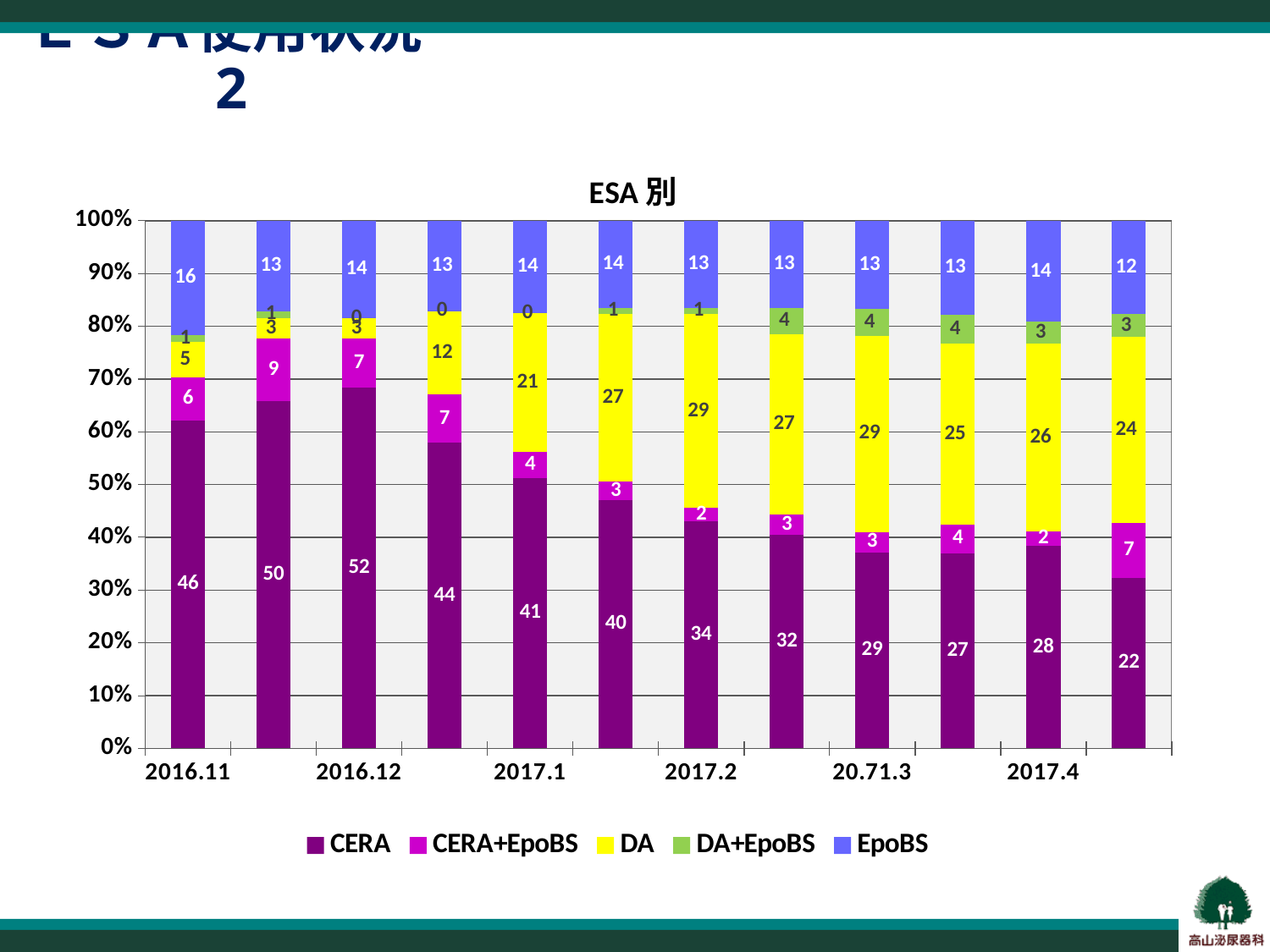
What kind of chart is shown on the slide? Stacked bar chart How many series does the legend list? 5 What is the CERA value for 2016.11? 46 What is the difference between the CERA value for 2016.11 and the CERA value for 2017.4? 18 What is the DA value for 2017.2? 29 What is the CERA value for 2017.4? 28 What is the title of the chart? ESA 別 What is the EpoBS value for 2016.11? 16 Among the labeled x-axis categories, which has the highest CERA value? 2016.12 Which is larger: the DA value for 2017.1 or the DA value for 2017.2? 2017.2 Does the CERA value generally rise or fall from 2016.12 to 2017.4? Fall How many bars are plotted in the chart? 12